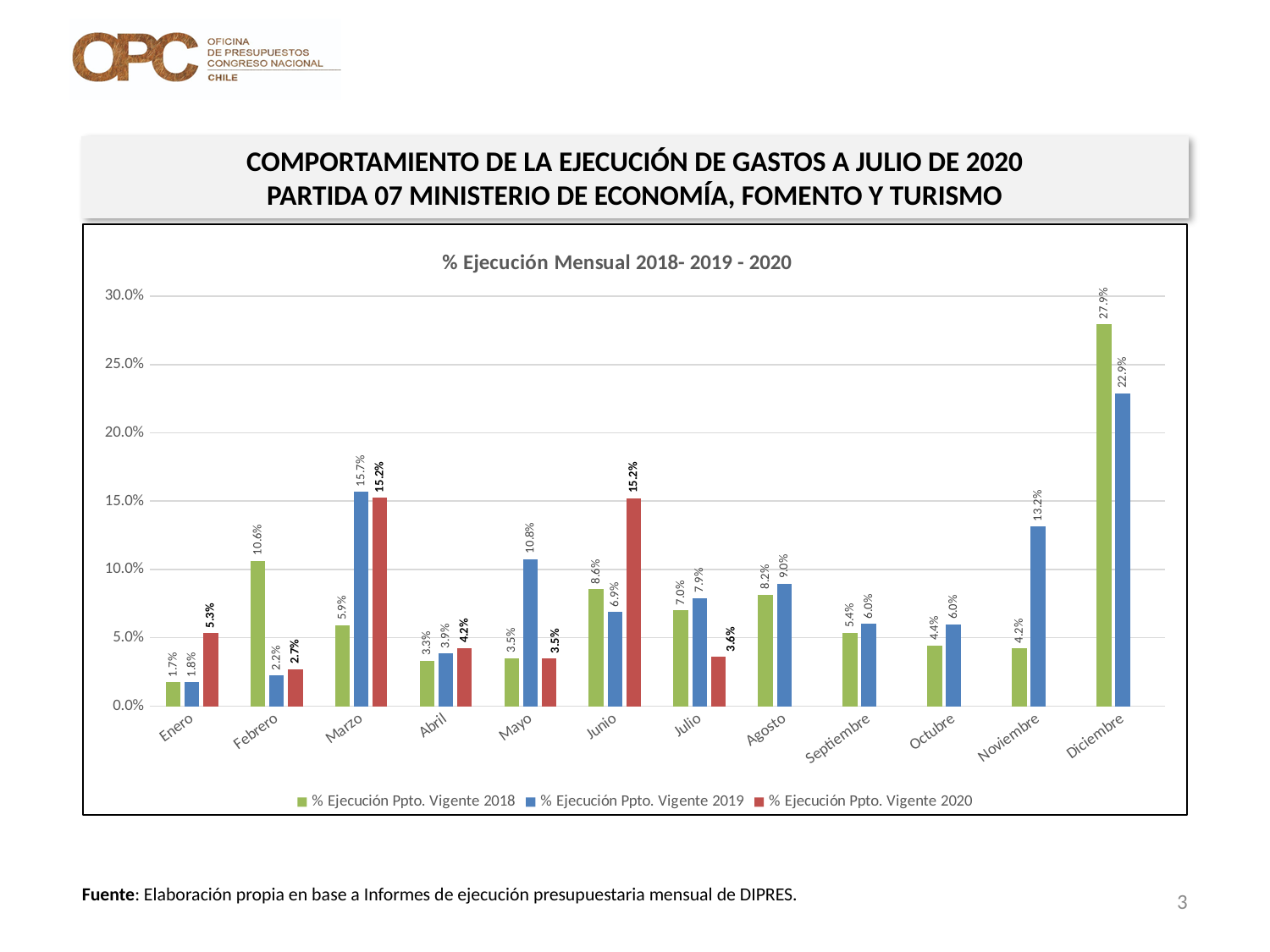
What is the title of the chart? % Ejecución Mensual 2018- 2019 - 2020 Is the value for % Ejecución Ppto. Vigente 2019 in Diciembre greater or less than 20.0%? greater How many series does the legend list? 3 In which month is the % Ejecución Ppto. Vigente 2020 series highest? Marzo and Junio (both 15.2%) What is the difference between the 2019 and 2018 values in Noviembre? 9.0% What is the value for % Ejecución Ppto. Vigente 2019 in Marzo? 15.7% What is the value for % Ejecución Ppto. Vigente 2018 in Diciembre? 27.9% What is the value for % Ejecución Ppto. Vigente 2020 in Enero? 5.3% How many months are shown on the x axis? 12 What kind of chart is shown? Bar chart Which is larger in Febrero: the 2018 value or the 2019 value? 2018 In which month is the % Ejecución Ppto. Vigente 2018 series lowest? Enero